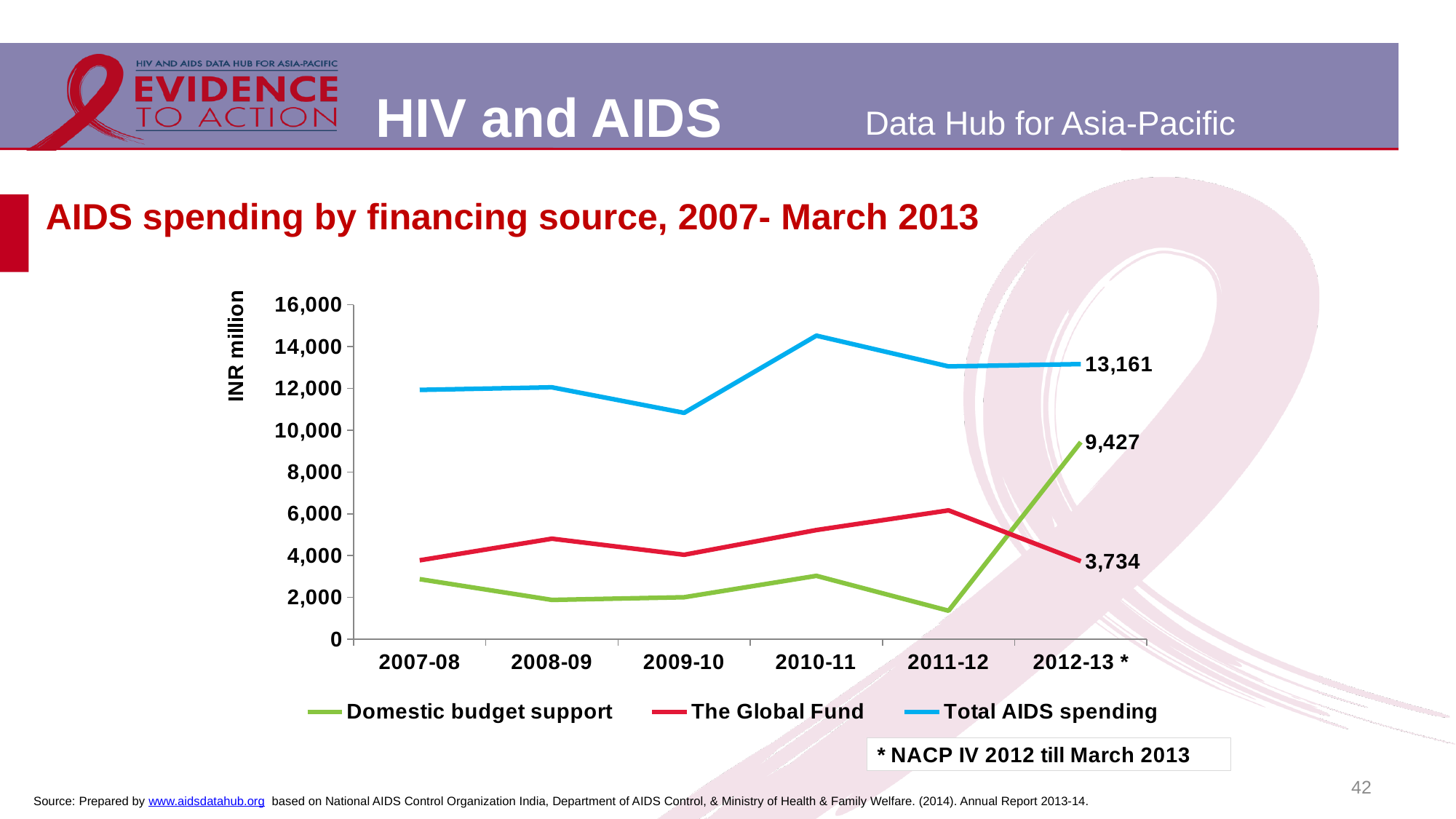
How many periods are shown on the x axis? 6 What kind of chart is shown on the slide? line chart What is the value of The Global Fund in 2012-13 *? 3,734 In which period is The Global Fund highest? 2011-12 In 2012-13 *, how much larger is Domestic budget support than The Global Fund? 5,693 In which period is Total AIDS spending highest? 2010-11 How many series does the legend list? 3 What is the value of Domestic budget support in 2012-13 *? 9,427 In 2012-13 *, which is larger: Domestic budget support or The Global Fund? Domestic budget support Is the value of Total AIDS spending in 2010-11 greater or less than 14,000? greater What is the value of Total AIDS spending in 2012-13 *? 13,161 Is the value of Domestic budget support in 2011-12 greater or less than 2,000? less